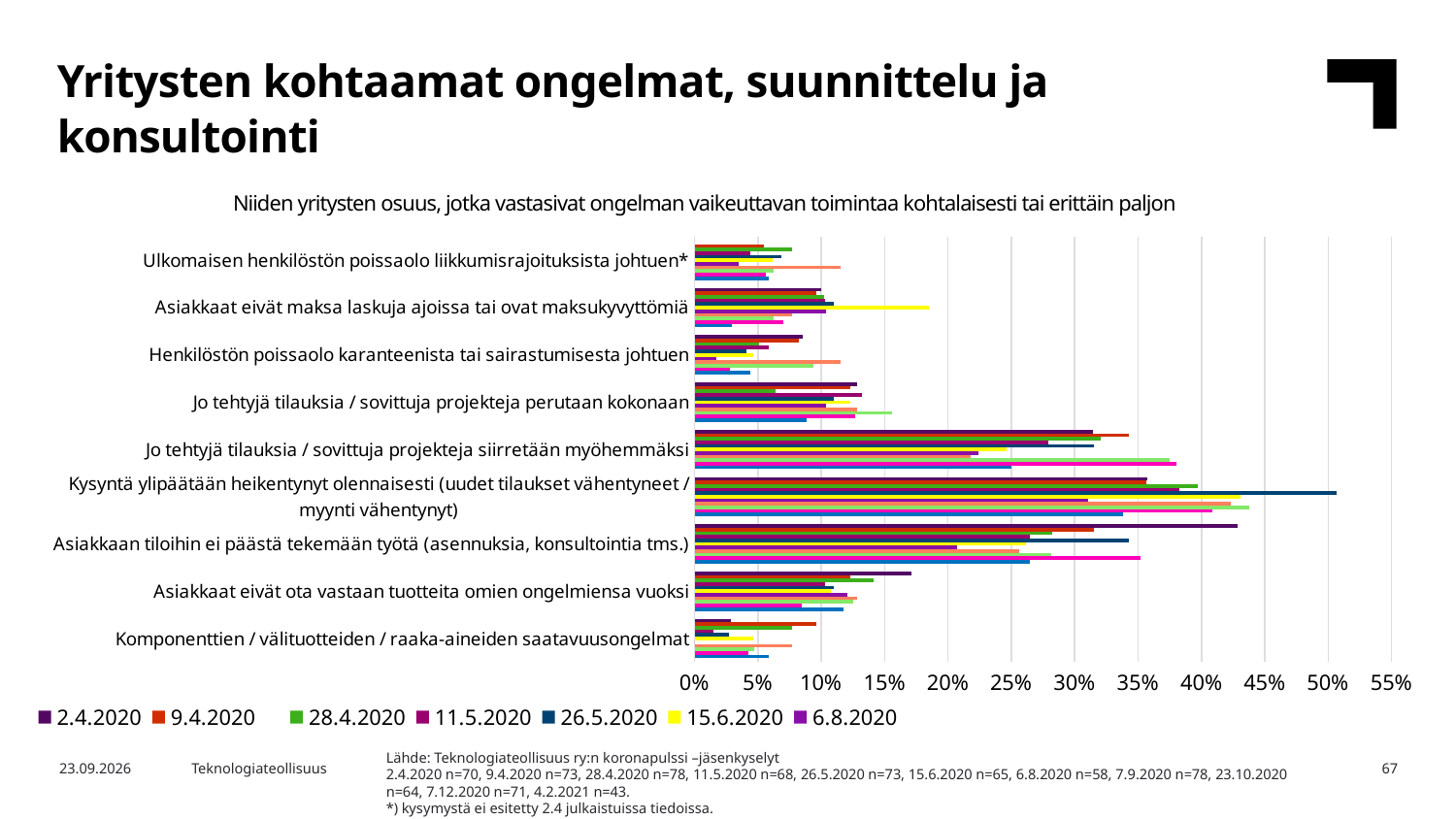
How many series does the chart legend list? 7 How many categories (problem types) are listed on the vertical axis of the chart? 9 What is the first series listed in the chart legend? 2.4.2020 Is the 2.4.2020 value for 'Asiakkaan tiloihin ei päästä tekemään työtä' greater or less than 25%? greater What is the highest value shown on the horizontal axis of the chart? 55% Which category has the longest bar in the chart? Kysyntä ylipäätään heikentynyt olennaisesti (uudet tilaukset vähentyneet / myynti vähentynyt) Is the longest bar for 'Kysyntä ylipäätään heikentynyt olennaisesti' greater or less than 45%? greater Is the 15.6.2020 value for 'Asiakkaat eivät maksa laskuja ajoissa tai ovat maksukyvyttömiä' greater or less than 15%? greater What kind of chart is shown on the slide? bar chart For the 2.4.2020 series, which is larger: 'Jo tehtyjä tilauksia / sovittuja projekteja siirretään myöhemmäksi' or 'Jo tehtyjä tilauksia / sovittuja projekteja perutaan kokonaan'? Jo tehtyjä tilauksia / sovittuja projekteja siirretään myöhemmäksi